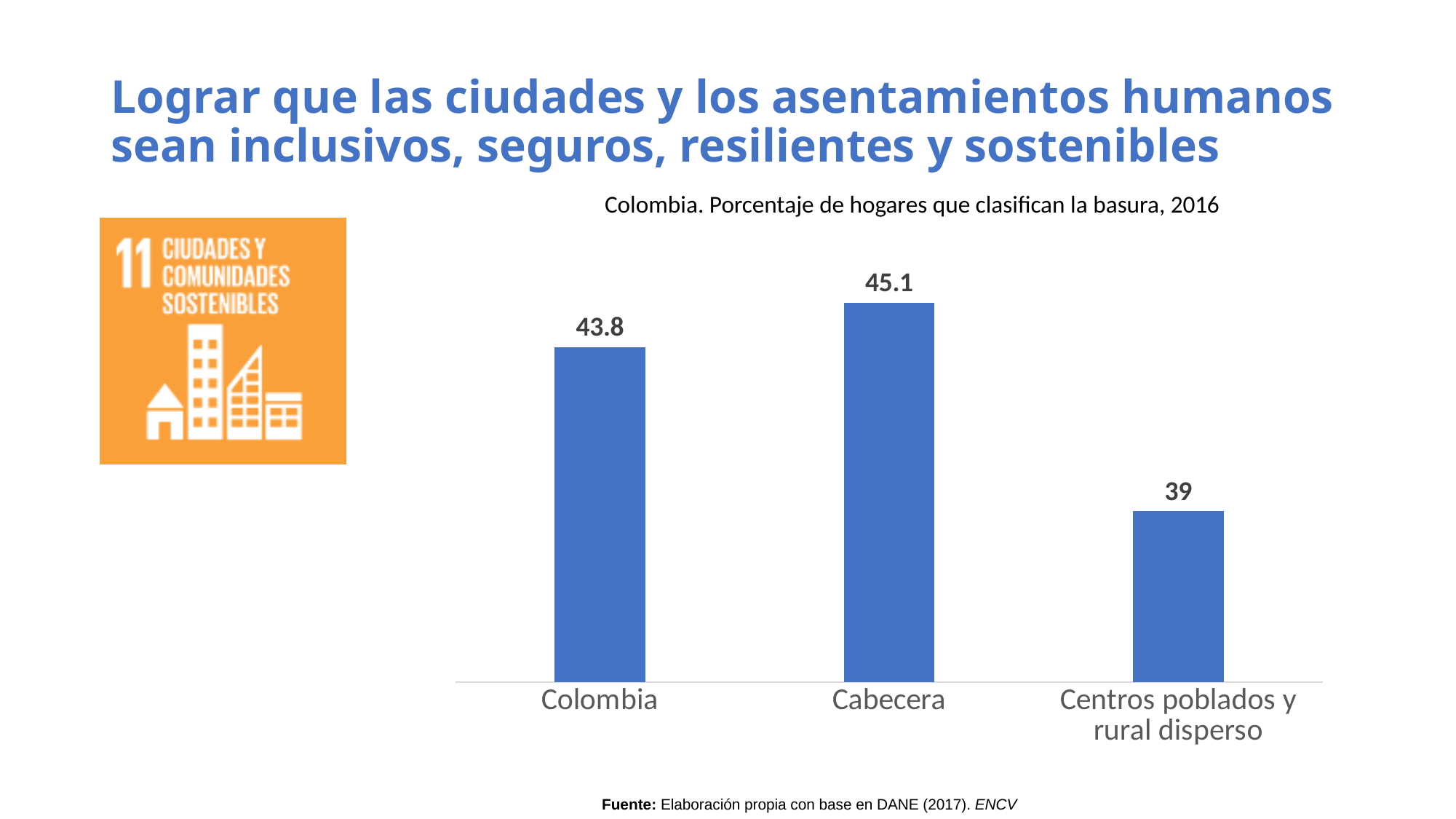
What is the value for Colombia? 43.8 Which category has the highest value? Cabecera How many categories are shown in the chart? 3 What colour are the bars in the chart? Blue Which category has the lowest value? Centros poblados y rural disperso What is the difference between the values for Cabecera and Centros poblados y rural disperso? 6.1 Which is larger, the value for Colombia or the value for Centros poblados y rural disperso? Colombia What is the difference between the values for Cabecera and Colombia? 1.3 What is the value for Cabecera? 45.1 What kind of chart is shown on the slide? Bar chart What is the value for Centros poblados y rural disperso? 39 What is the title of the chart? Colombia. Porcentaje de hogares que clasifican la basura, 2016